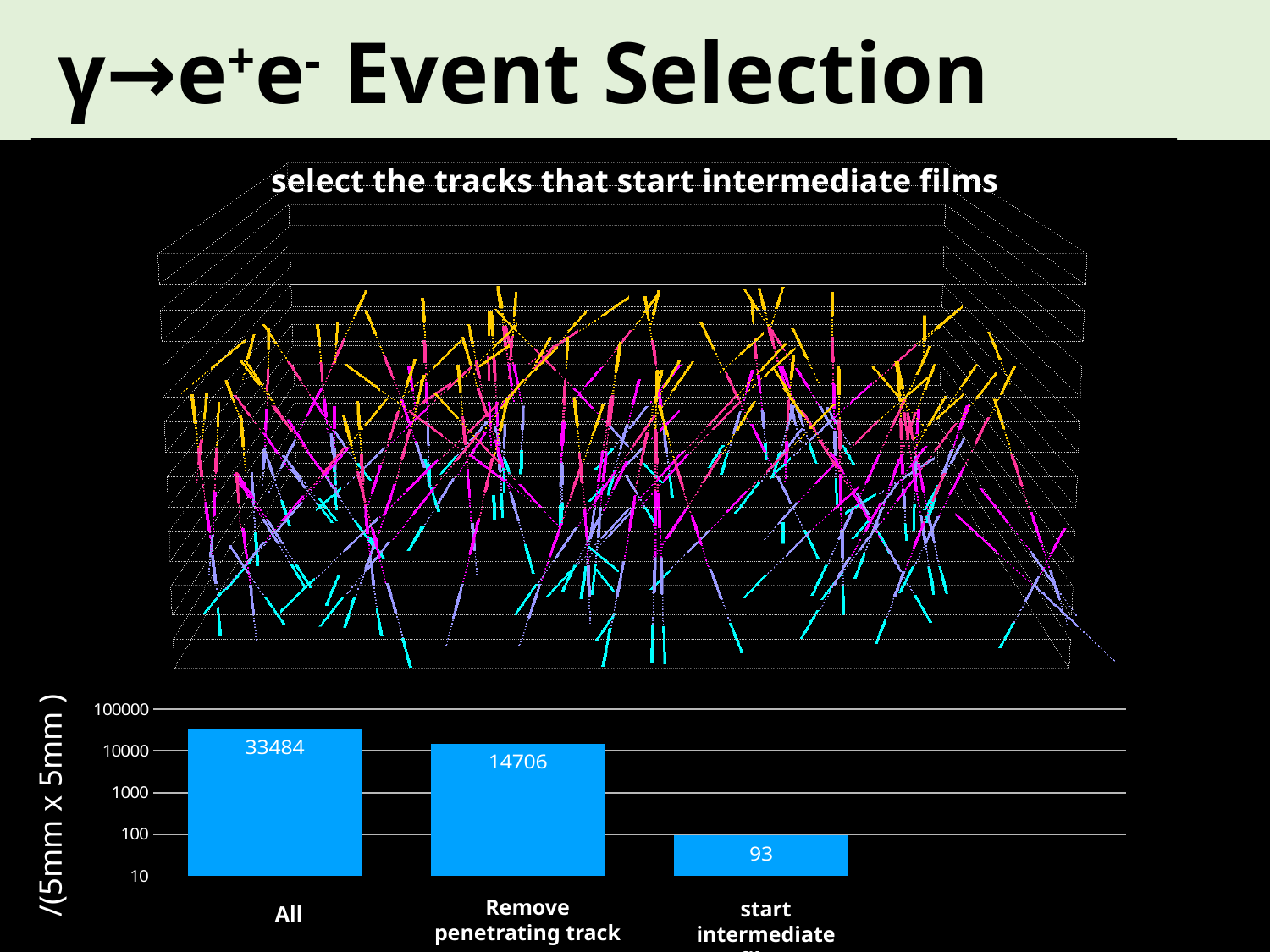
How many categories are shown in the bar chart? 3 Do the values in the bar chart rise or fall from left to right along the x axis? fall Is the value for "start intermediate" in the bar chart greater or less than 100? less What kind of chart is shown at the bottom of the slide? bar chart Which category in the bar chart has the highest value? All Which is larger in the bar chart: the value for "All" or the value for "Remove penetrating track"? All What is the difference between the values for "All" and "Remove penetrating track" in the bar chart? 18778 What is the difference between the values for "Remove penetrating track" and "start intermediate" in the bar chart? 14613 Which category in the bar chart has the lowest value? start intermediate What is the value for the "start intermediate" category in the bar chart? 93 What is the value for the "Remove penetrating track" category in the bar chart? 14706 What is the value for the "All" category in the bar chart? 33484